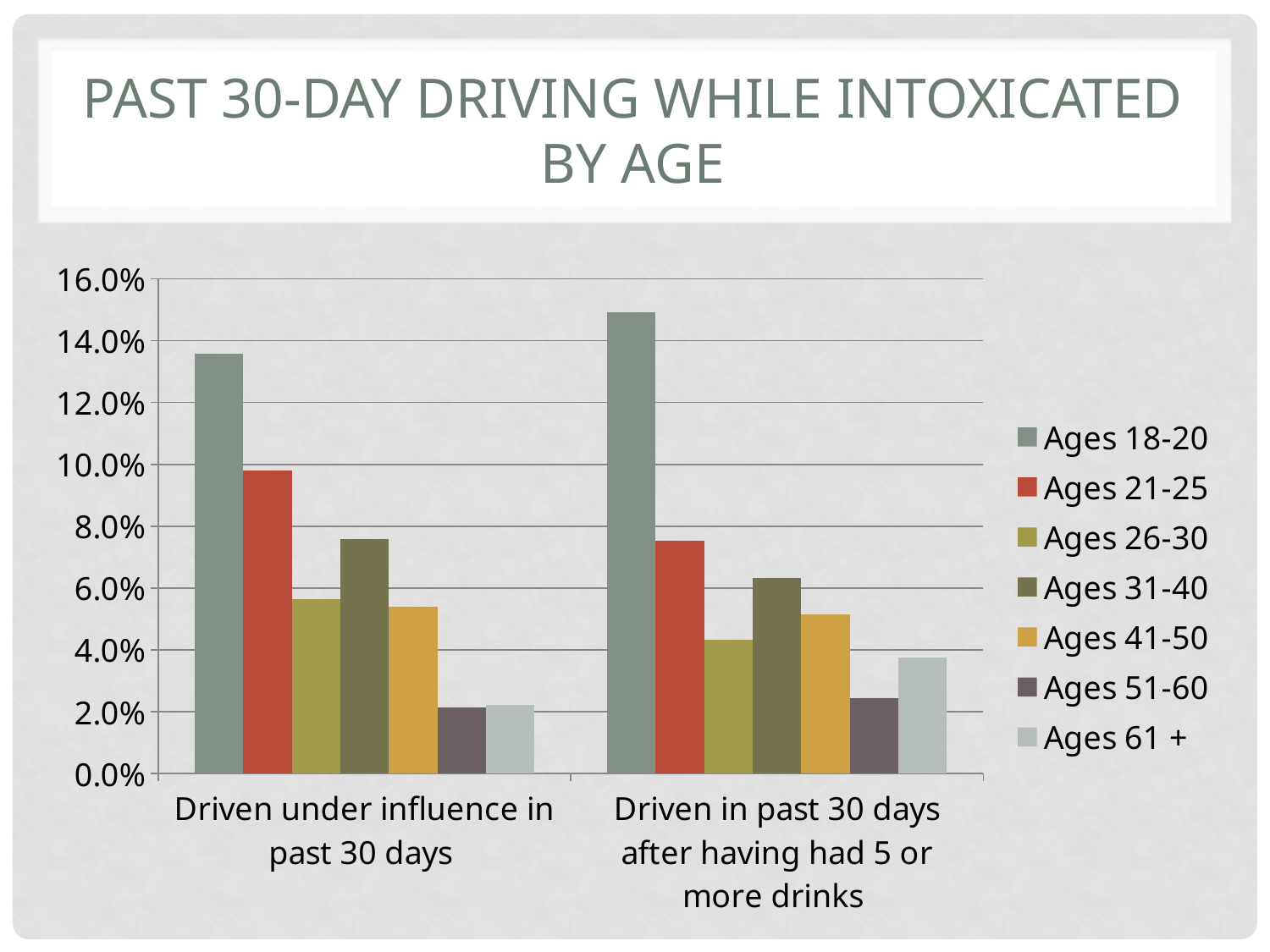
Is the value for Ages 18-20 in "Driven in past 30 days after having had 5 or more drinks" greater or less than 14.0%? greater Which age group has the highest value for "Driven in past 30 days after having had 5 or more drinks"? Ages 18-20 For "Driven under influence in past 30 days", which is larger: Ages 26-30 or Ages 31-40? Ages 31-40 Is the value for Ages 21-25 in "Driven under influence in past 30 days" greater or less than 10.0%? less How many categories are shown on the x axis? 2 For Ages 21-25, which category has the larger value: "Driven under influence in past 30 days" or "Driven in past 30 days after having had 5 or more drinks"? Driven under influence in past 30 days Which age group has the lowest value for "Driven in past 30 days after having had 5 or more drinks"? Ages 51-60 What kind of chart is shown on the slide? bar chart Which age group has the highest value for "Driven under influence in past 30 days"? Ages 18-20 What is the title of the slide? Past 30-Day Driving While Intoxicated by Age How many series does the legend list? 7 Is the value for Ages 31-40 in "Driven in past 30 days after having had 5 or more drinks" greater or less than 6.0%? greater